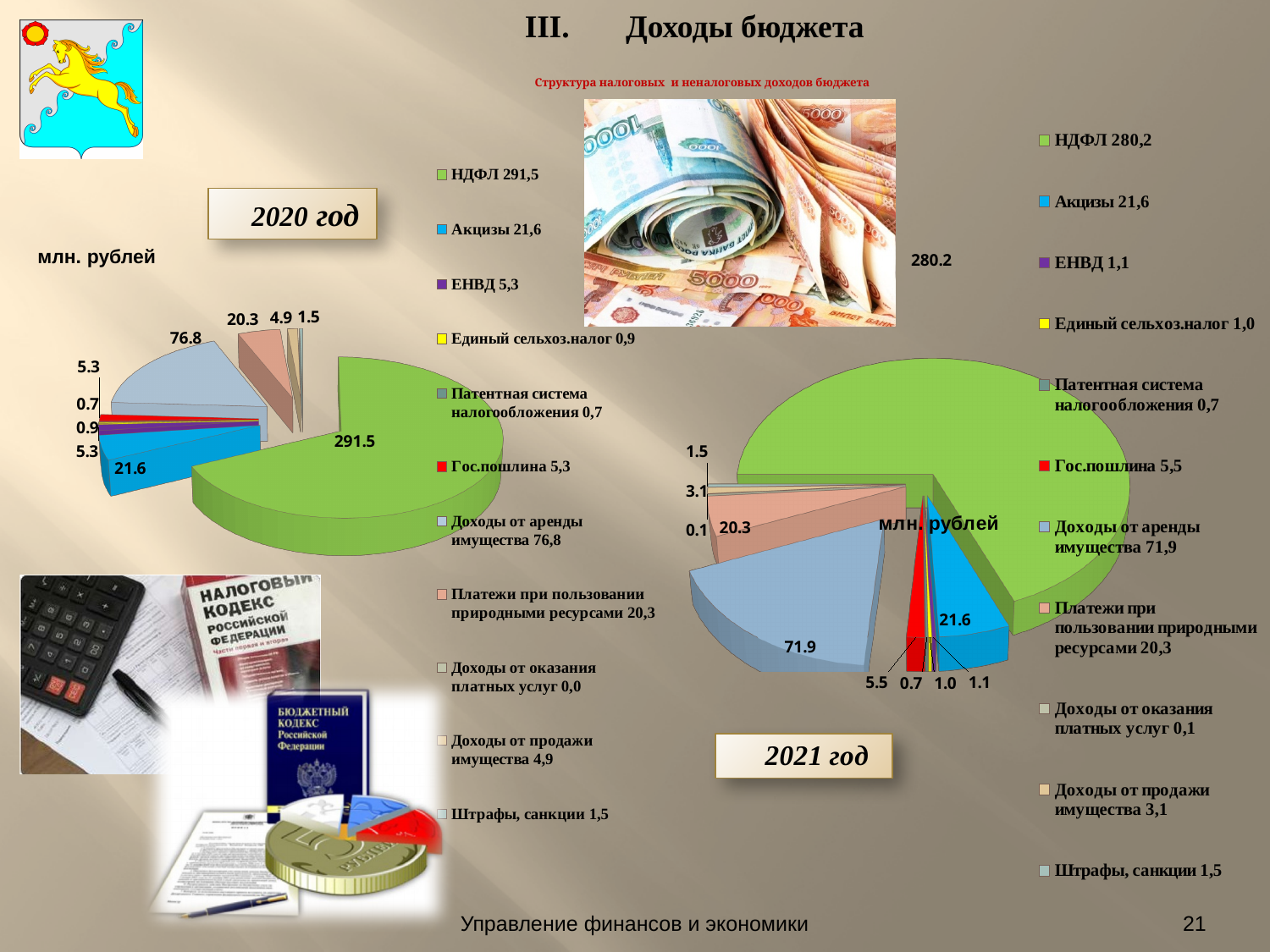
In the 2020 год chart, what colour is the НДФЛ slice? green In the 2021 год chart, what is the value for Доходы от аренды имущества? 71.9 In the 2020 год chart, what is the value for НДФЛ? 291.5 In the 2021 год chart, what is the difference between Доходы от аренды имущества and Акцизы? 50.3 How many categories does the legend of the 2021 год chart list? 11 What is the difference between the НДФЛ value in the 2020 год chart and the НДФЛ value in the 2021 год chart? 11.3 What kind of chart is used for the 2020 год data? pie chart In the 2020 год chart, what is the value for Платежи при пользовании природными ресурсами? 20.3 In the 2021 год chart, which is larger: Гос.пошлина or Доходы от продажи имущества? Гос.пошлина In the 2021 год chart, what is the value for НДФЛ? 280.2 In the 2020 год chart, which category has the largest value? НДФЛ In the 2020 год chart, which category has the smallest value? Доходы от оказания платных услуг